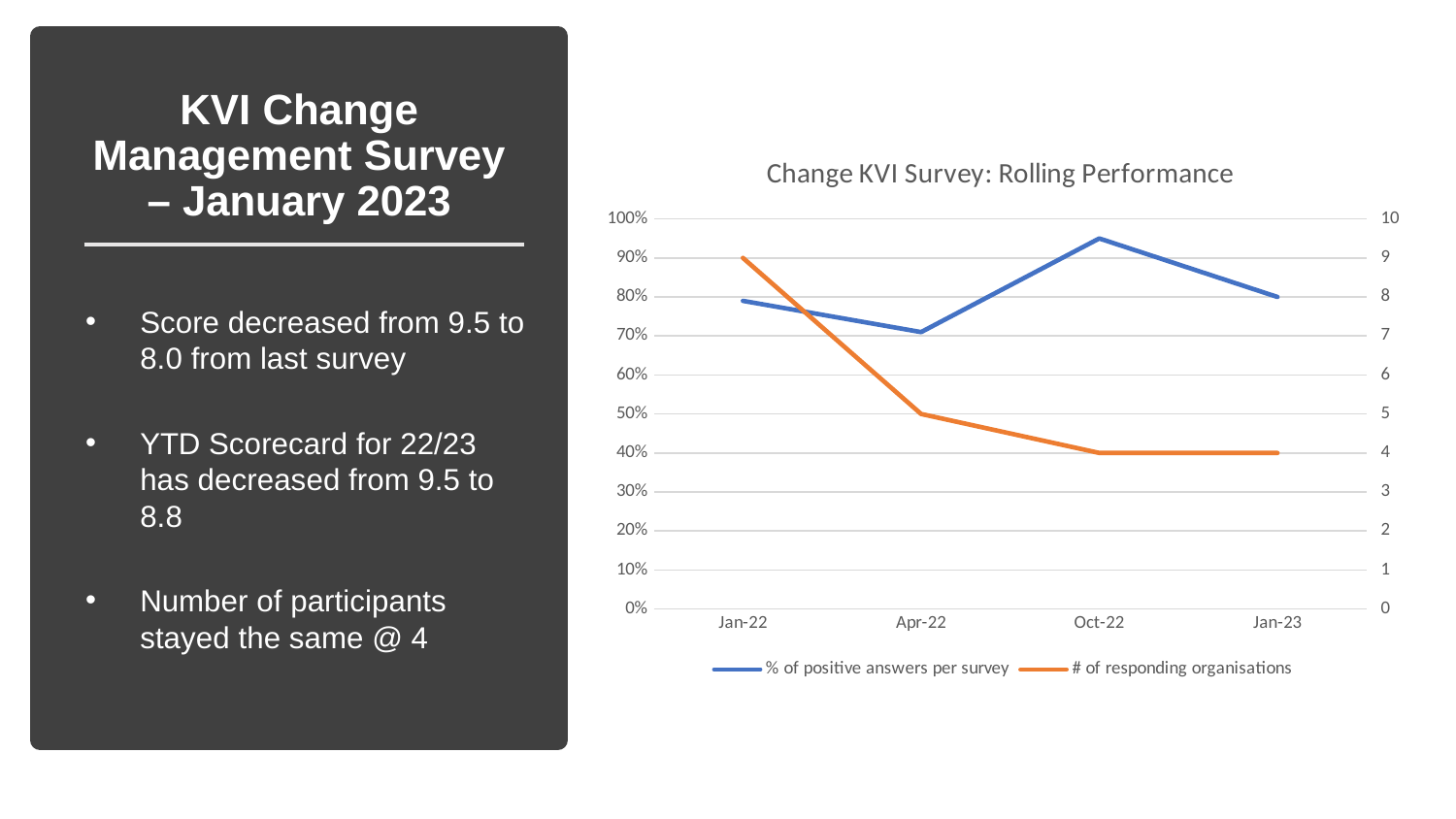
What is the number of responding organisations for Jan-23? 4 At which survey date is the % of positive answers per survey lowest? Apr-22 At which survey date is the % of positive answers per survey highest? Oct-22 What is the number of responding organisations for Apr-22? 5 What is the difference in the number of responding organisations between Jan-22 and Jan-23? 5 Is the % of positive answers per survey for Oct-22 greater or less than 90%? greater What is the number of responding organisations for Jan-22? 9 What kind of chart is shown on the slide? Line chart How many survey dates are plotted along the x axis of the chart? 4 What is the title of the chart? Change KVI Survey: Rolling Performance How many series does the legend of the chart list? 2 Does the number of responding organisations rise or fall from Jan-22 to Jan-23? Fall